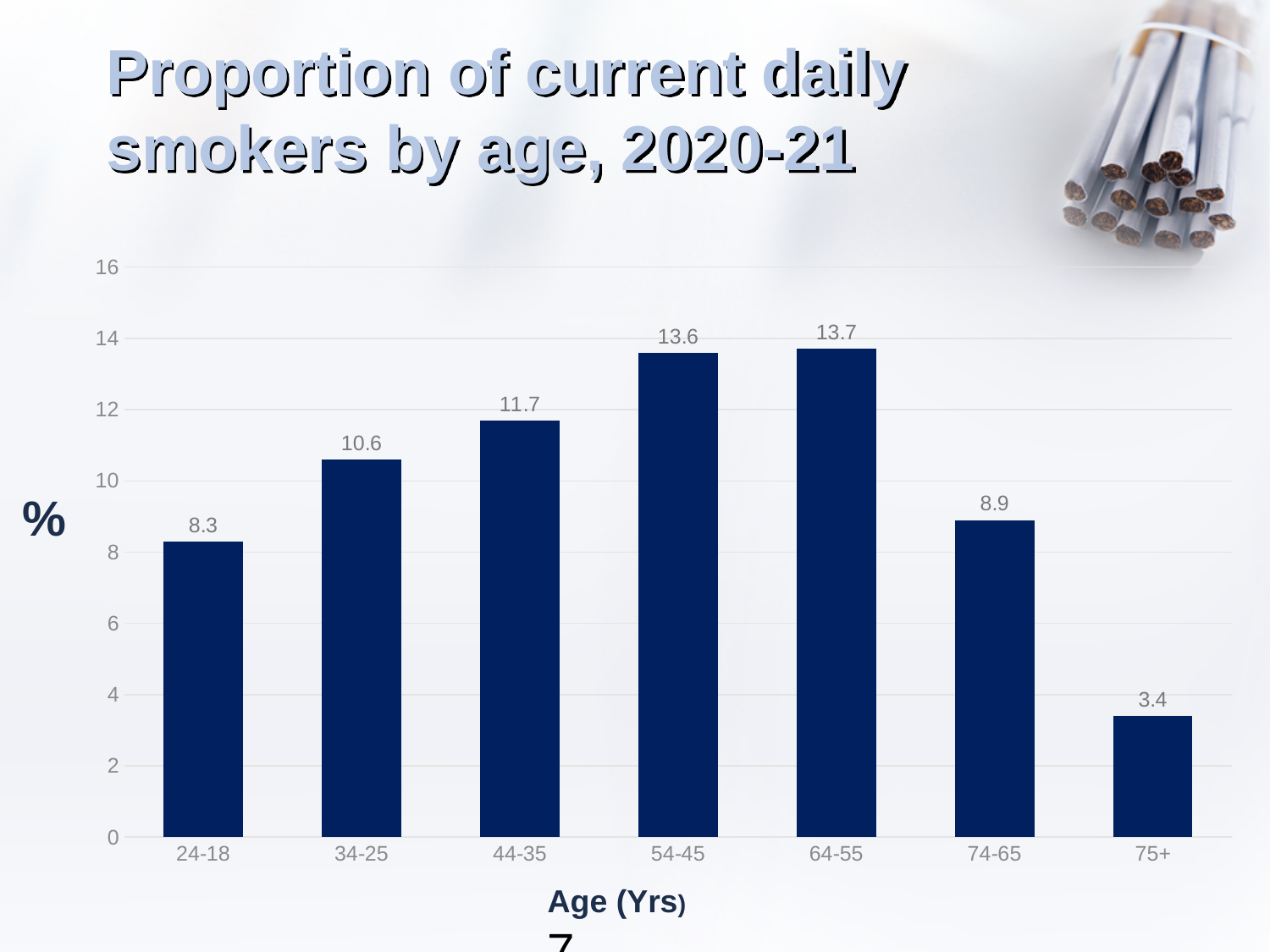
What is the difference between the values for the 44-35 and 34-25 age groups? 1.1 Which age group has the highest proportion of current daily smokers? 64-55 How many age groups are shown on the chart? 7 What is the title of the chart on the slide? Proportion of current daily smokers by age, 2020-21 What is the value for the 24-18 age group? 8.3 Is the value for the 44-35 age group greater or less than 10? greater What is the value for the 74-65 age group? 8.9 Which age group has the lowest proportion of current daily smokers? 75+ What kind of chart is shown on the slide? bar chart What is the value for the 75+ age group? 3.4 What is the value for the 54-45 age group? 13.6 Which is larger, the value for 34-25 or the value for 74-65? 34-25